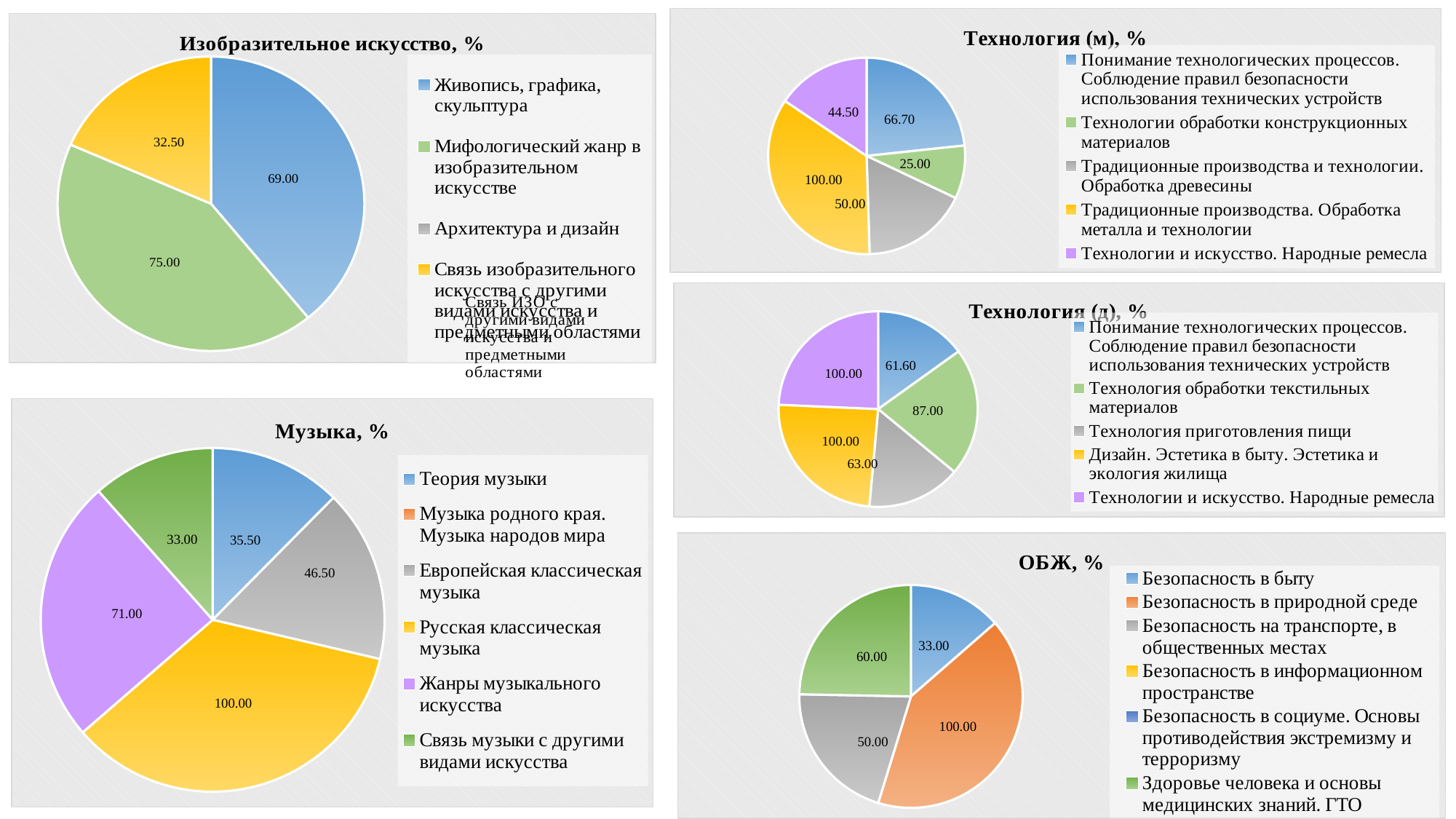
In the "Технология (д), %" chart, which is larger: "Технология приготовления пищи" or "Понимание технологических процессов. Соблюдение правил безопасности использования технических устройств"? Технология приготовления пищи In the "ОБЖ, %" chart, how many entries does the legend list? 6 In the "ОБЖ, %" chart, what is the value for "Здоровье человека и основы медицинских знаний. ГТО"? 60.00 In the "Технология (м), %" chart, which category has the smallest value? Технологии обработки конструкционных материалов In the "Технология (д), %" chart, what is the value for "Технология обработки текстильных материалов"? 87.00 In the "Музыка, %" chart, what is the value for "Европейская классическая музыка"? 46.50 In the "Изобразительное искусство, %" chart, what is the value for "Живопись, графика, скульптура"? 69.00 What type of chart is the "ОБЖ, %" chart? Pie chart In the "Технология (м), %" chart, what is the value for "Технологии и искусство. Народные ремесла"? 44.50 In the "Музыка, %" chart, what is the difference between "Русская классическая музыка" and "Жанры музыкального искусства"? 29.00 In the "Изобразительное искусство, %" chart, which category has the largest slice? Мифологический жанр в изобразительном искусстве In the "Музыка, %" chart, which category has the smallest slice? Связь музыки с другими видами искусства